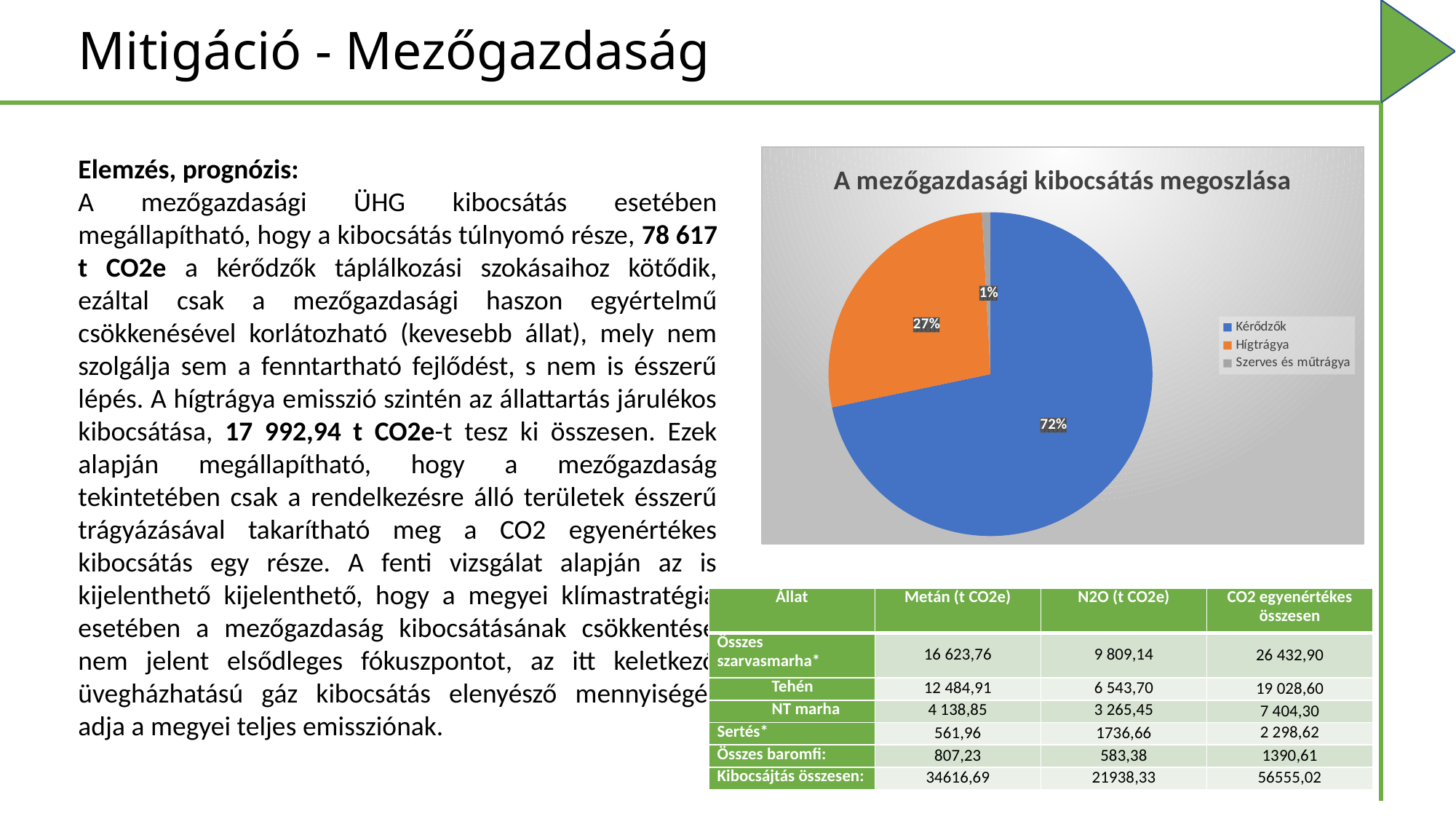
What share of the pie does Kérődzők have? 72% What kind of chart is shown on the slide? pie chart What is the difference in percentage points between the Hígtrágya and Szerves és műtrágya slices? 26 What share of the pie does Szerves és műtrágya have? 1% How many categories does the pie chart show? 3 Which category has the largest slice of the pie? Kérődzők Which is larger, the Hígtrágya slice or the Szerves és műtrágya slice? Hígtrágya What is the difference in percentage points between the Kérődzők and Hígtrágya slices? 45 What colour is the Hígtrágya slice in the pie chart? orange Which category has the smallest slice of the pie? Szerves és műtrágya What share of the pie does Hígtrágya have? 27% What is the title of the pie chart? A mezőgazdasági kibocsátás megoszlása